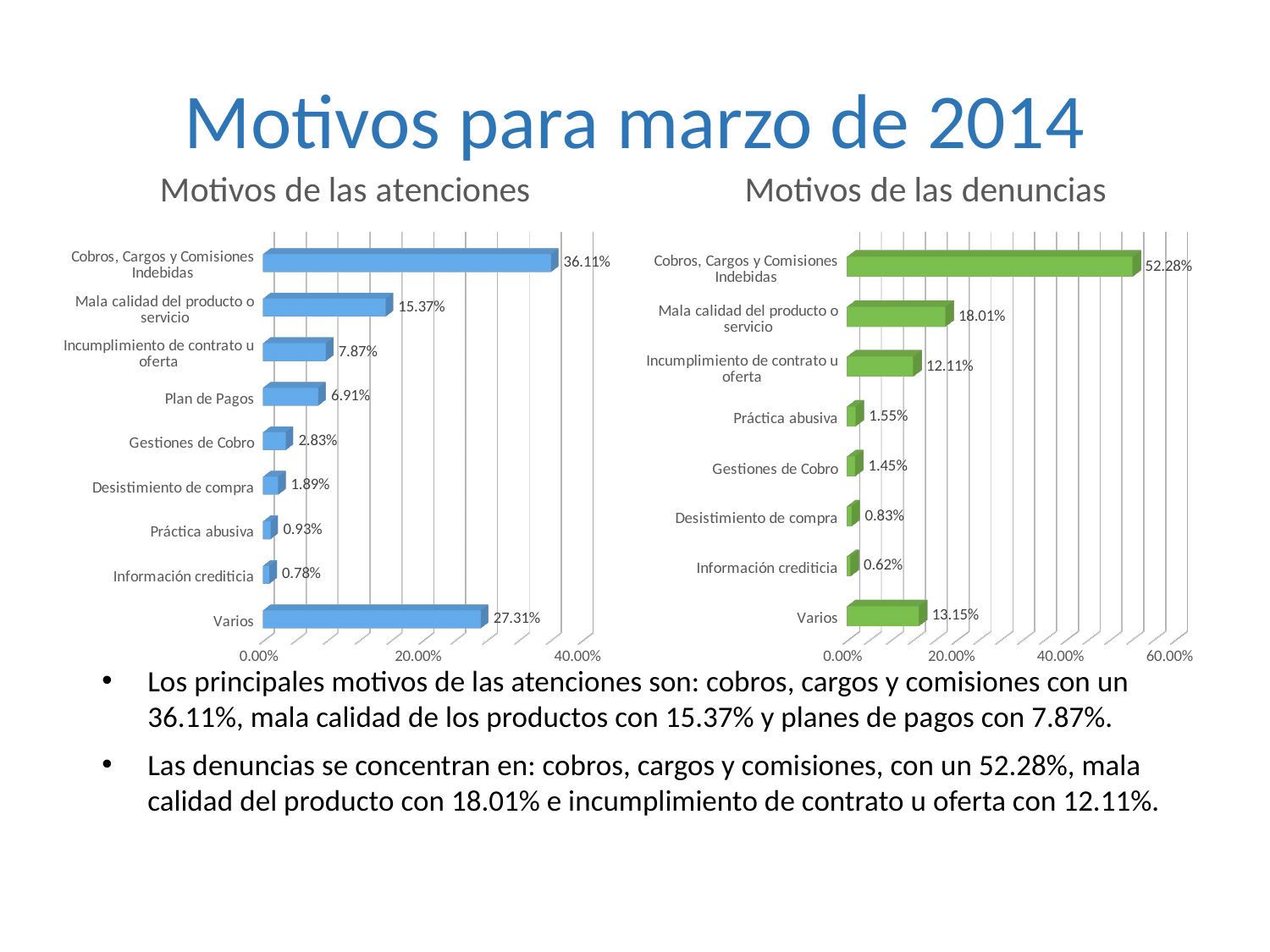
What colour are the bars in the 'Motivos de las denuncias' chart? Green In the 'Motivos de las atenciones' chart, which category has the highest value? Cobros, Cargos y Comisiones Indebidas What kind of chart is 'Motivos de las denuncias'? Bar chart In the 'Motivos de las denuncias' chart, which category has the lowest value? Información crediticia In the 'Motivos de las denuncias' chart, what is the difference between Práctica abusiva and Gestiones de Cobro? 0.10% In the 'Motivos de las atenciones' chart, what is the difference between Cobros, Cargos y Comisiones Indebidas and Varios? 8.80% In the 'Motivos de las denuncias' chart, is the value for Cobros, Cargos y Comisiones Indebidas greater or less than 40.00%? greater In the 'Motivos de las denuncias' chart, what is the value for Incumplimiento de contrato u oferta? 12.11% In the 'Motivos de las denuncias' chart, which is larger: Varios or Mala calidad del producto o servicio? Mala calidad del producto o servicio How many categories are shown in the 'Motivos de las atenciones' chart? 9 In the 'Motivos de las atenciones' chart, what is the value for Gestiones de Cobro? 2.83% In the 'Motivos de las atenciones' chart, what is the value for Plan de Pagos? 6.91%